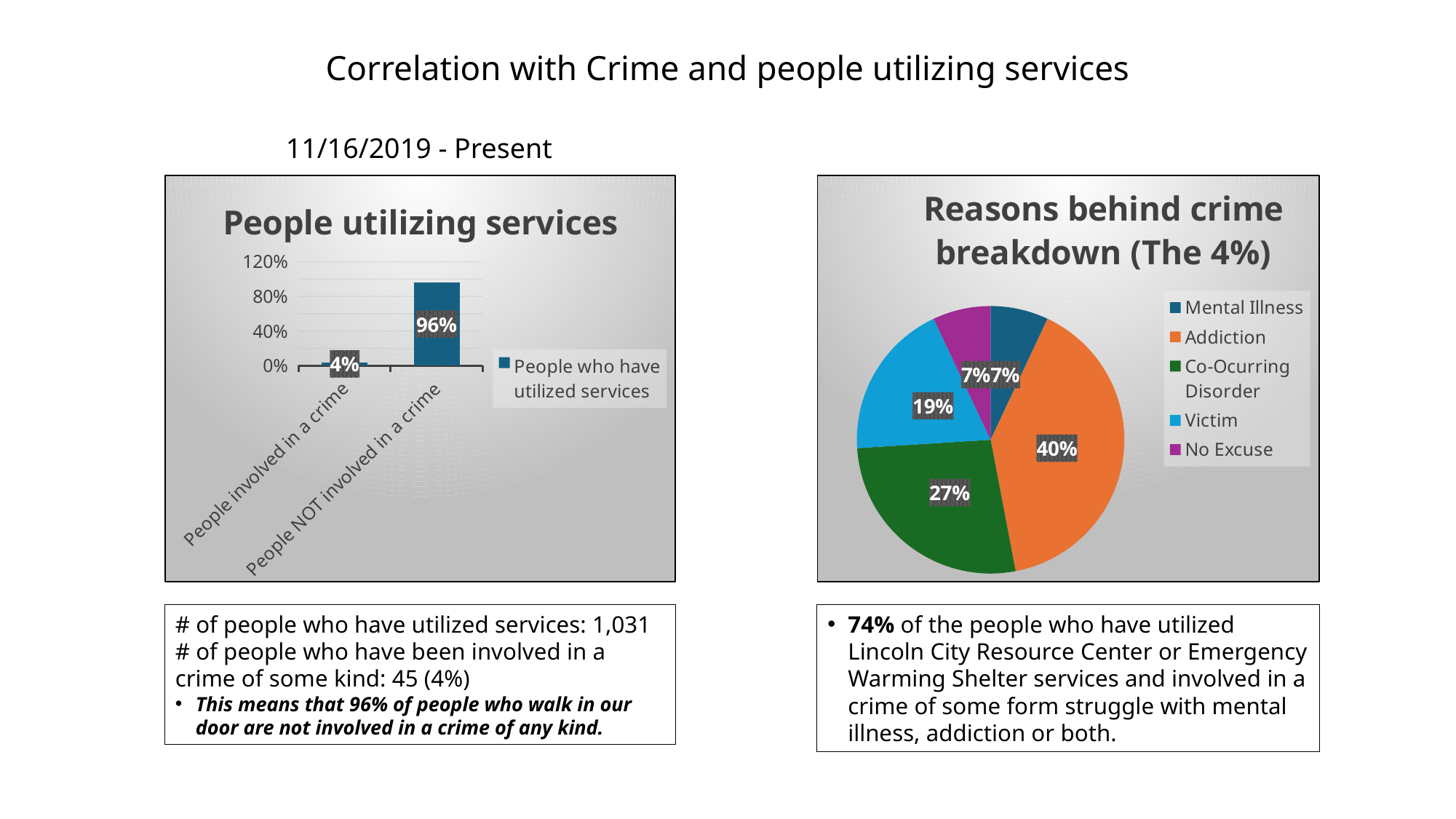
What kind of chart is 'People utilizing services'? bar chart In the 'People utilizing services' chart, what is the value for 'People involved in a crime'? 4% What kind of chart is 'Reasons behind crime breakdown (The 4%)'? pie chart In the 'Reasons behind crime breakdown (The 4%)' chart, which is larger, Victim or Co-Ocurring Disorder? Co-Ocurring Disorder How many categories does the legend of the 'Reasons behind crime breakdown (The 4%)' chart list? 5 In the 'Reasons behind crime breakdown (The 4%)' chart, which category has the largest slice? Addiction How many categories does the 'People utilizing services' chart show? 2 In the 'Reasons behind crime breakdown (The 4%)' chart, what share is Addiction? 40% In the 'People utilizing services' chart, what is the value for 'People NOT involved in a crime'? 96% In the 'Reasons behind crime breakdown (The 4%)' chart, what share is Victim? 19% In the 'People utilizing services' chart, what is the difference between the two bars? 92% In the 'Reasons behind crime breakdown (The 4%)' chart, what share is Co-Ocurring Disorder? 27%